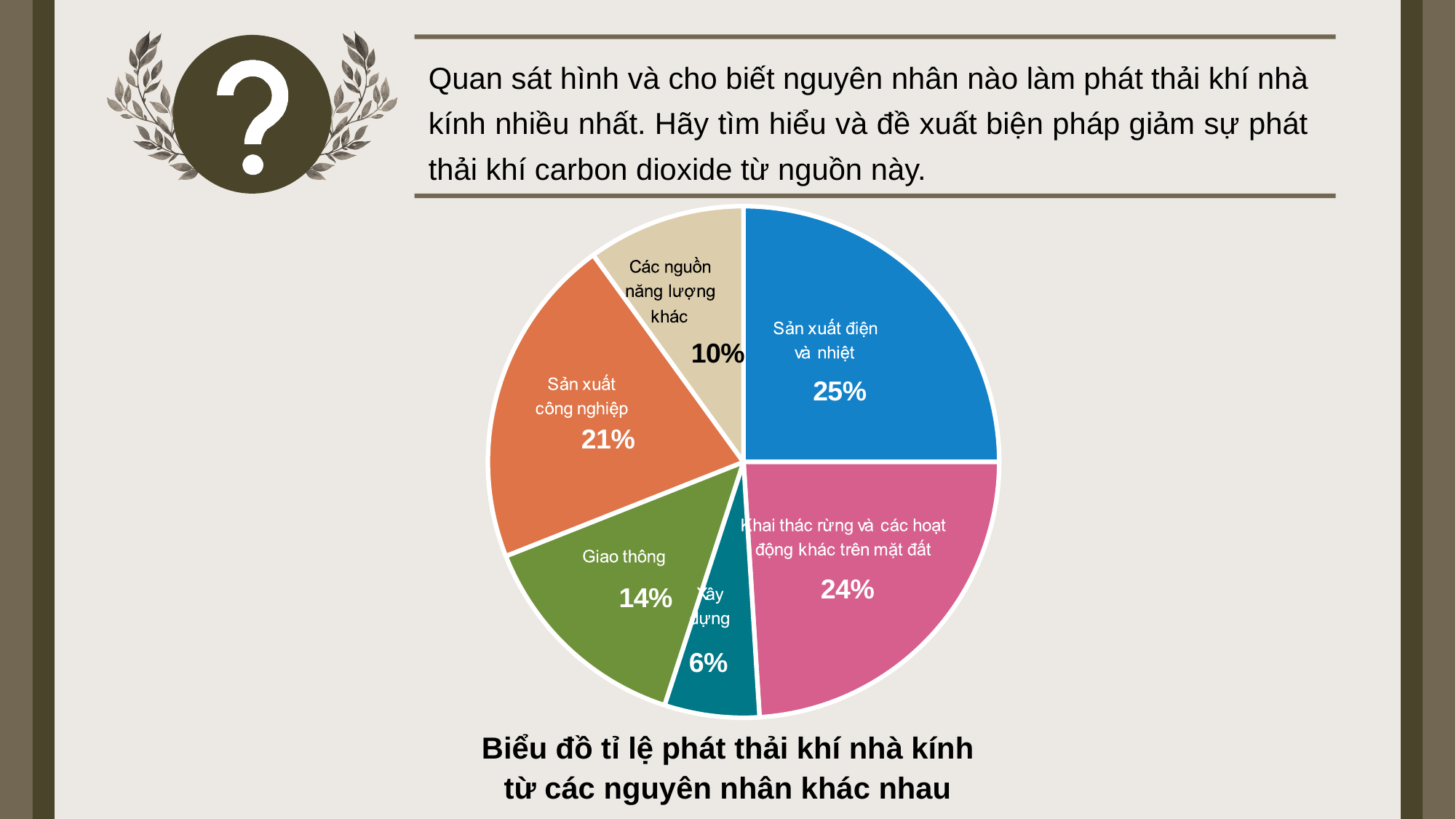
What percentage does the 'Xây dựng' slice represent? 6% Which is larger: 'Khai thác rừng và các hoạt động khác trên mặt đất' or 'Sản xuất công nghiệp'? Khai thác rừng và các hoạt động khác trên mặt đất What type of chart is shown on the slide? Pie chart What percentage does the 'Sản xuất điện và nhiệt' slice represent? 25% What is the title of the chart? Biểu đồ tỉ lệ phát thải khí nhà kính từ các nguyên nhân khác nhau What colour is the 'Giao thông' slice? Green What is the difference in percentage points between 'Sản xuất công nghiệp' and 'Giao thông'? 7 Which category has the smallest share of the pie? Xây dựng How many slices does the pie chart have? 6 What percentage does the 'Giao thông' slice represent? 14% What percentage does the 'Các nguồn năng lượng khác' slice represent? 10% Which category has the largest share of the pie? Sản xuất điện và nhiệt